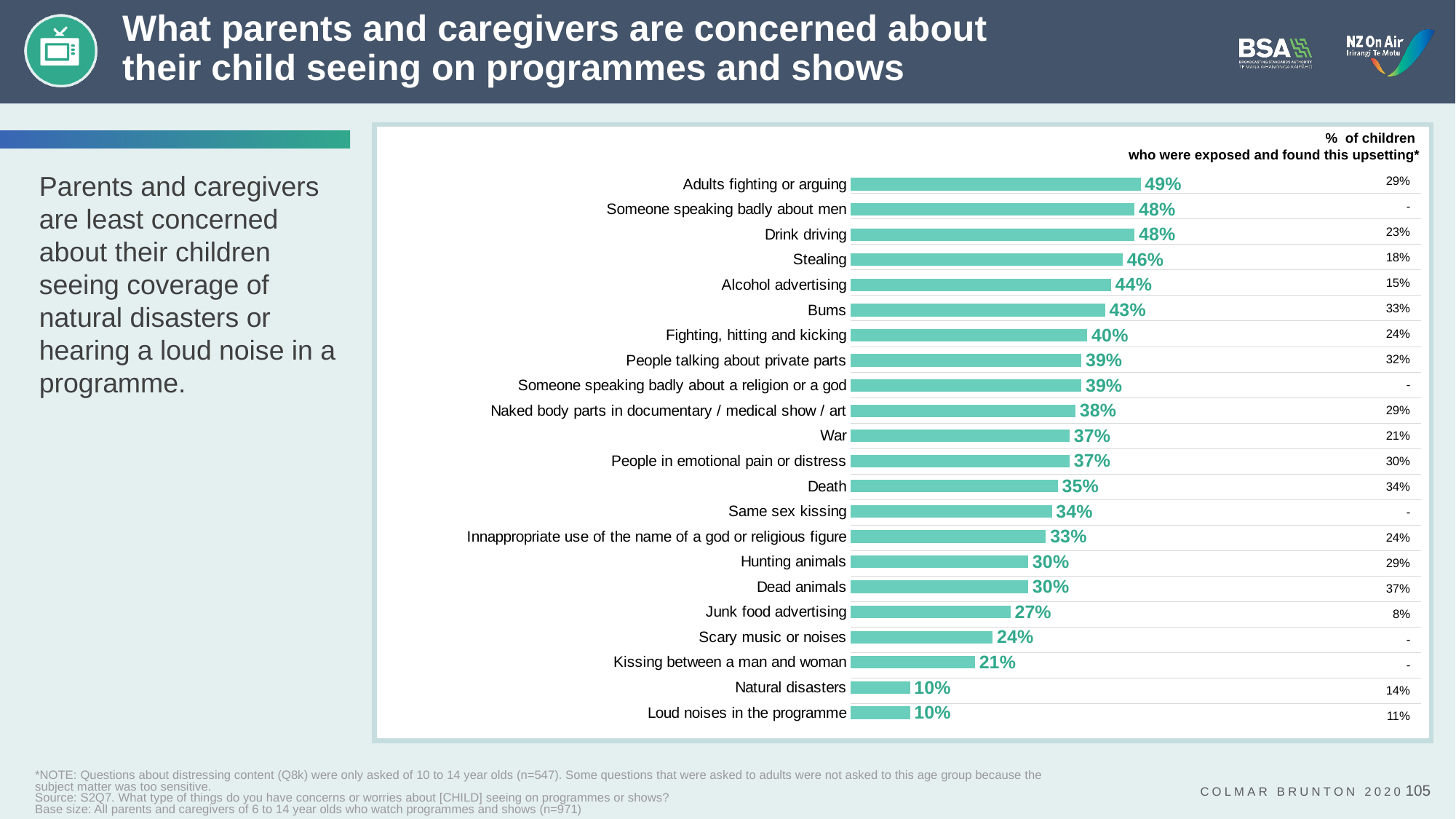
What percentage of parents and caregivers are concerned about their child seeing adults fighting or arguing? 49% What is the difference between the values for Adults fighting or arguing and Natural disasters? 39% In the right-hand column, what percentage of children who were exposed to Dead animals found this upsetting? 37% Which is larger, the value for Bums or the value for War? Bums Which category has the highest percentage of concerned parents and caregivers? Adults fighting or arguing How many categories are plotted on the chart? 22 What is the value shown for Junk food advertising? 27% What is the difference between the values for Drink driving and Stealing? 2% Which two categories share the lowest value on the chart? Natural disasters and Loud noises in the programme What kind of chart is shown on the slide? Bar chart What is the value shown for Same sex kissing? 34% Which is larger, the value for Hunting animals or the value for Scary music or noises? Hunting animals